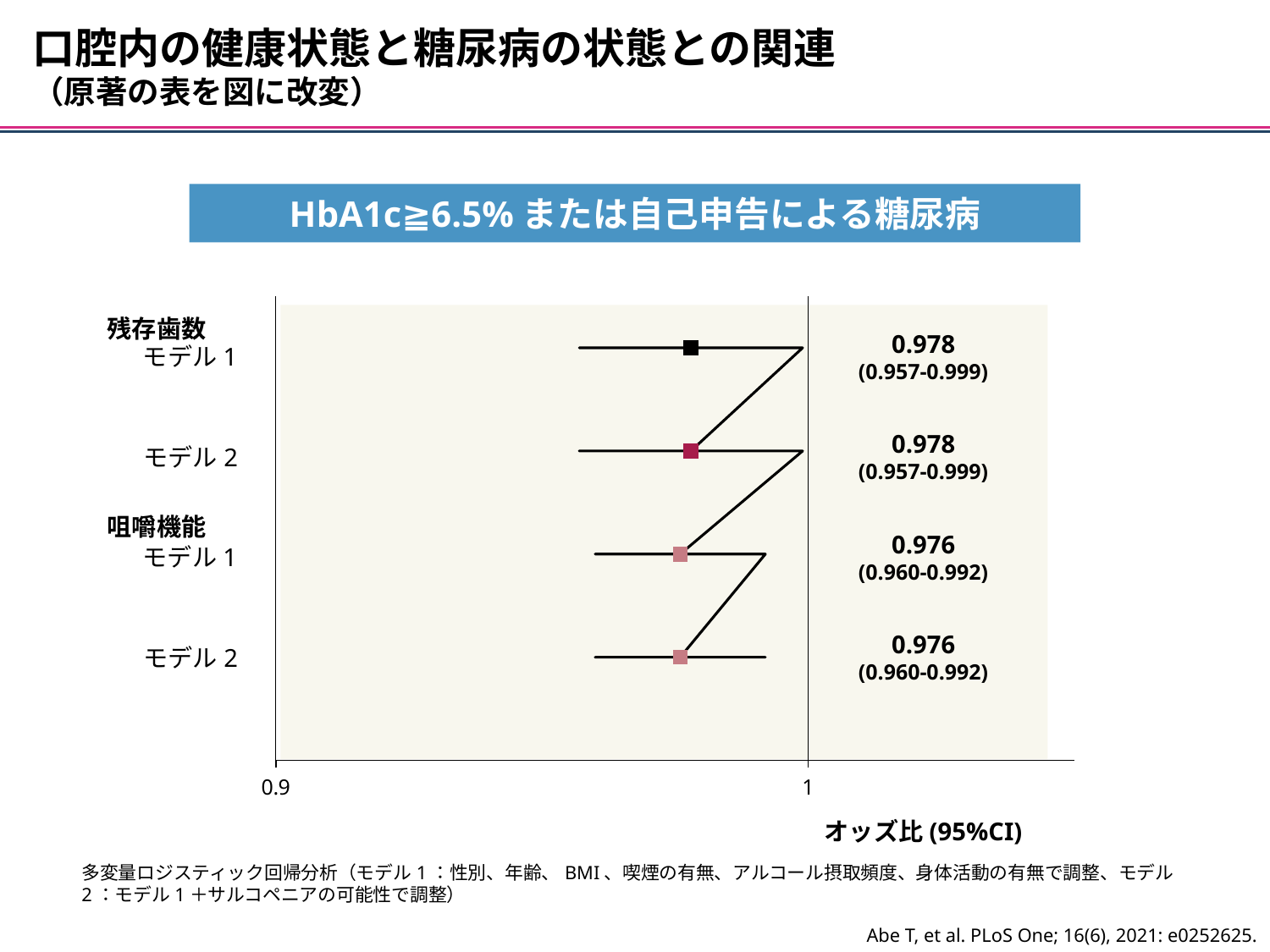
Is the odds ratio for 咀嚼機能 モデル 2 greater or less than 1? less Which has the larger odds ratio, 残存歯数 モデル 1 or 咀嚼機能 モデル 1? 残存歯数 モデル 1 What is the odds ratio for 咀嚼機能 モデル 1? 0.976 What kind of chart is shown on the slide? Forest plot What is the lowest odds ratio shown in the chart? 0.976 What is the 95% CI shown for 残存歯数 モデル 2? (0.957-0.999) What is the title shown above the chart? HbA1c≧6.5% または自己申告による糖尿病 How many odds ratio estimates are plotted in the chart? 4 What is the difference between the odds ratio for 残存歯数 モデル 2 and 咀嚼機能 モデル 2? 0.002 What is the label of the horizontal axis? オッズ比 (95%CI) What is the odds ratio for 残存歯数 モデル 1? 0.978 What is the 95% CI shown for 咀嚼機能 モデル 2? (0.960-0.992)